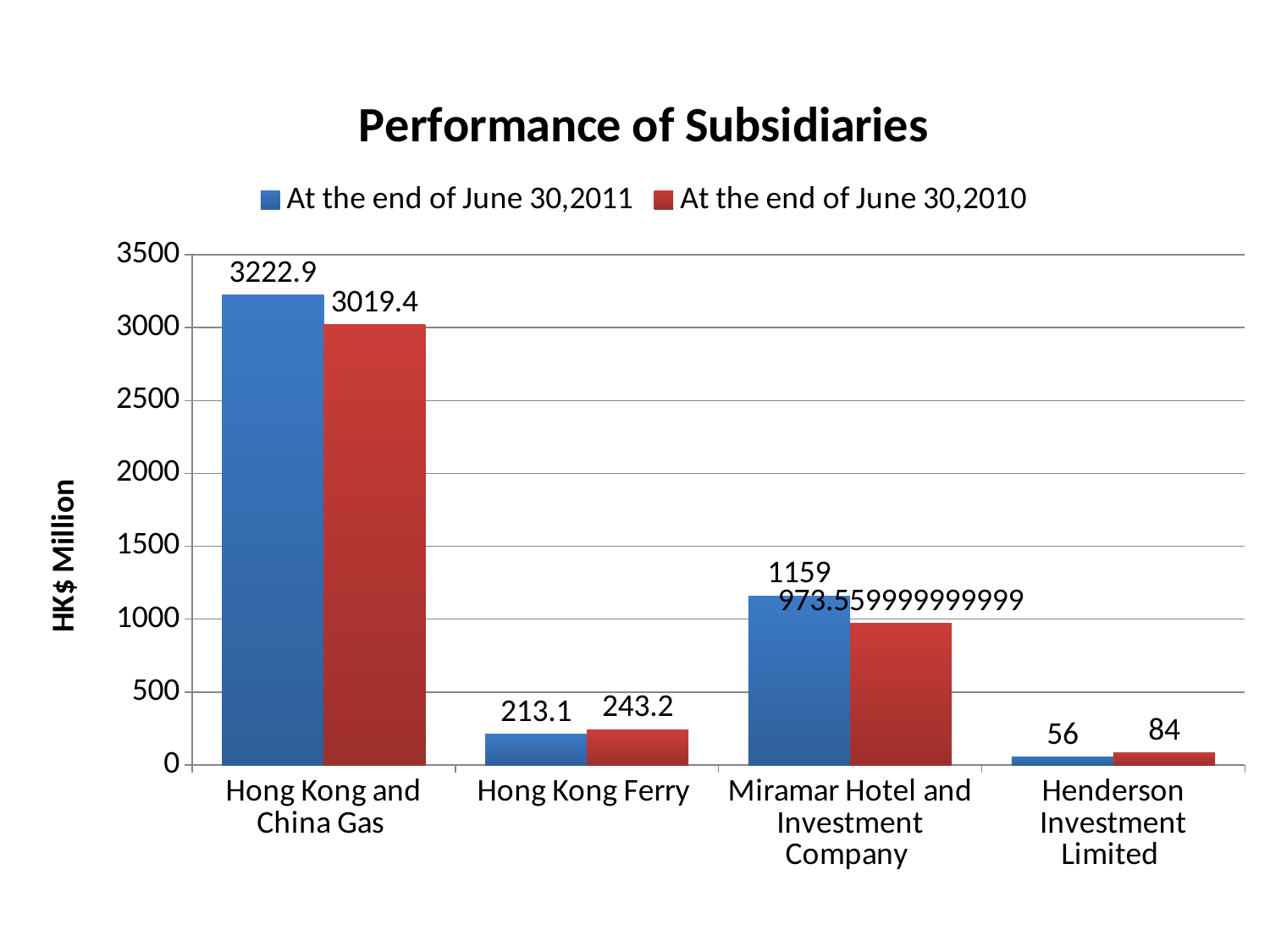
What type of chart is shown on the slide? Bar chart How many series does the legend list? 2 For Hong Kong Ferry, which is larger: the value at the end of June 30, 2011 or at the end of June 30, 2010? At the end of June 30,2010 Which subsidiary has the lowest value at the end of June 30, 2010? Henderson Investment Limited Which subsidiary has the highest value at the end of June 30, 2011? Hong Kong and China Gas What is the difference between the 2011 and 2010 values for Hong Kong and China Gas? 203.5 What is the value for Hong Kong and China Gas at the end of June 30, 2011? 3222.9 What is the value for Hong Kong and China Gas at the end of June 30, 2010? 3019.4 What is the value for Miramar Hotel and Investment Company at the end of June 30, 2011? 1159 What is the value for Henderson Investment Limited at the end of June 30, 2010? 84 What is the value for Hong Kong Ferry at the end of June 30, 2011? 213.1 How many subsidiaries are shown on the x axis? 4